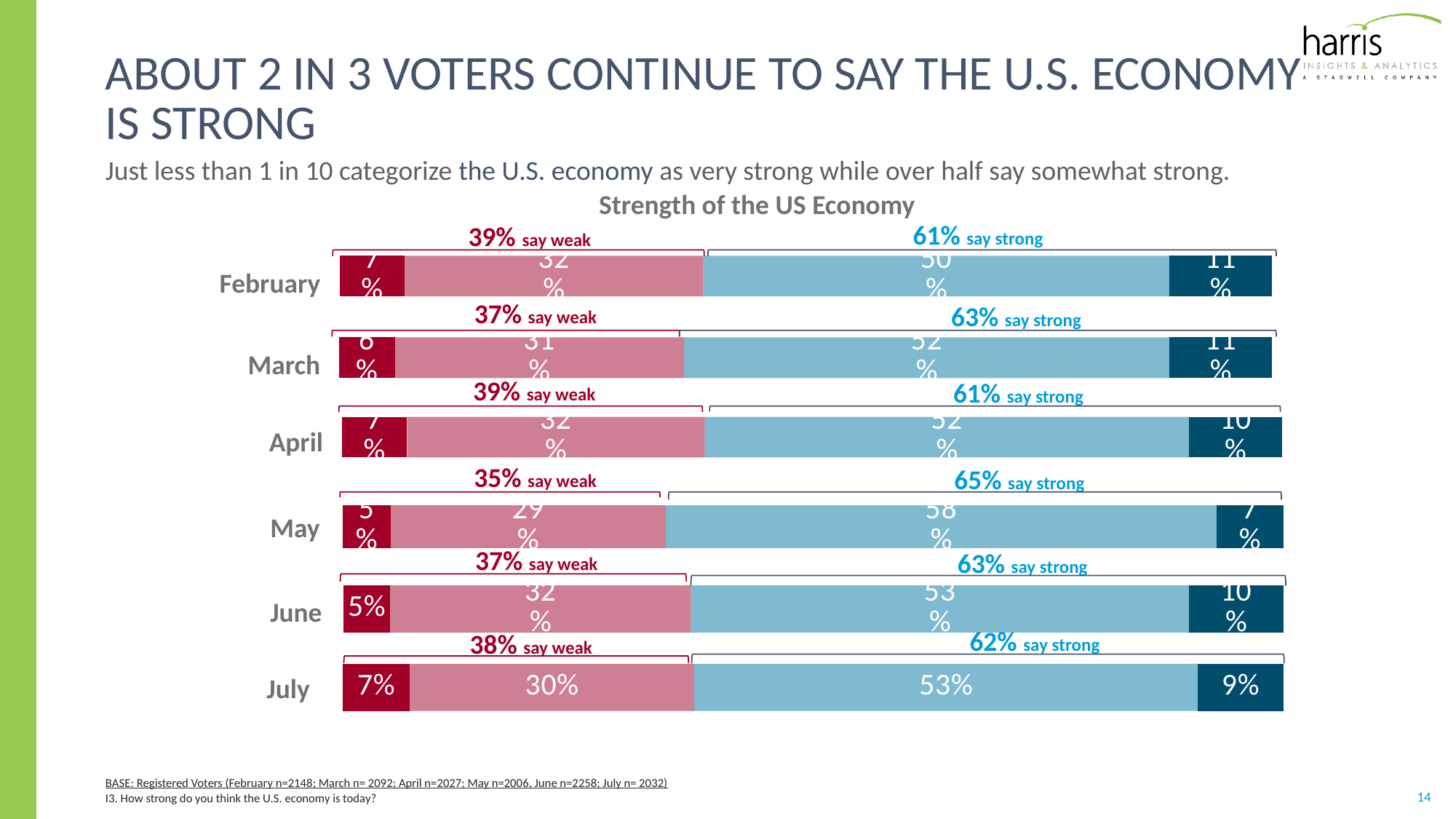
How many months are shown in the chart? 6 What percentage of voters say the economy is weak in July? 38% Which month has the highest share of voters saying the economy is strong? May What is the title of the chart? Strength of the US Economy What type of chart is used on this slide? Stacked bar chart In July, how many percentage points higher is the 'say strong' share than the 'say weak' share? 24 percentage points What value is shown in the light blue segment of the July bar? 53% What value is shown in the dark red (leftmost) segment of the July bar? 7% What value is shown in the dark blue (rightmost) segment of the July bar? 9% Which is larger: the 'say weak' share in February or in May? February Which month has the lowest share of voters saying the economy is weak? May What percentage of voters say the economy is strong in May? 65%